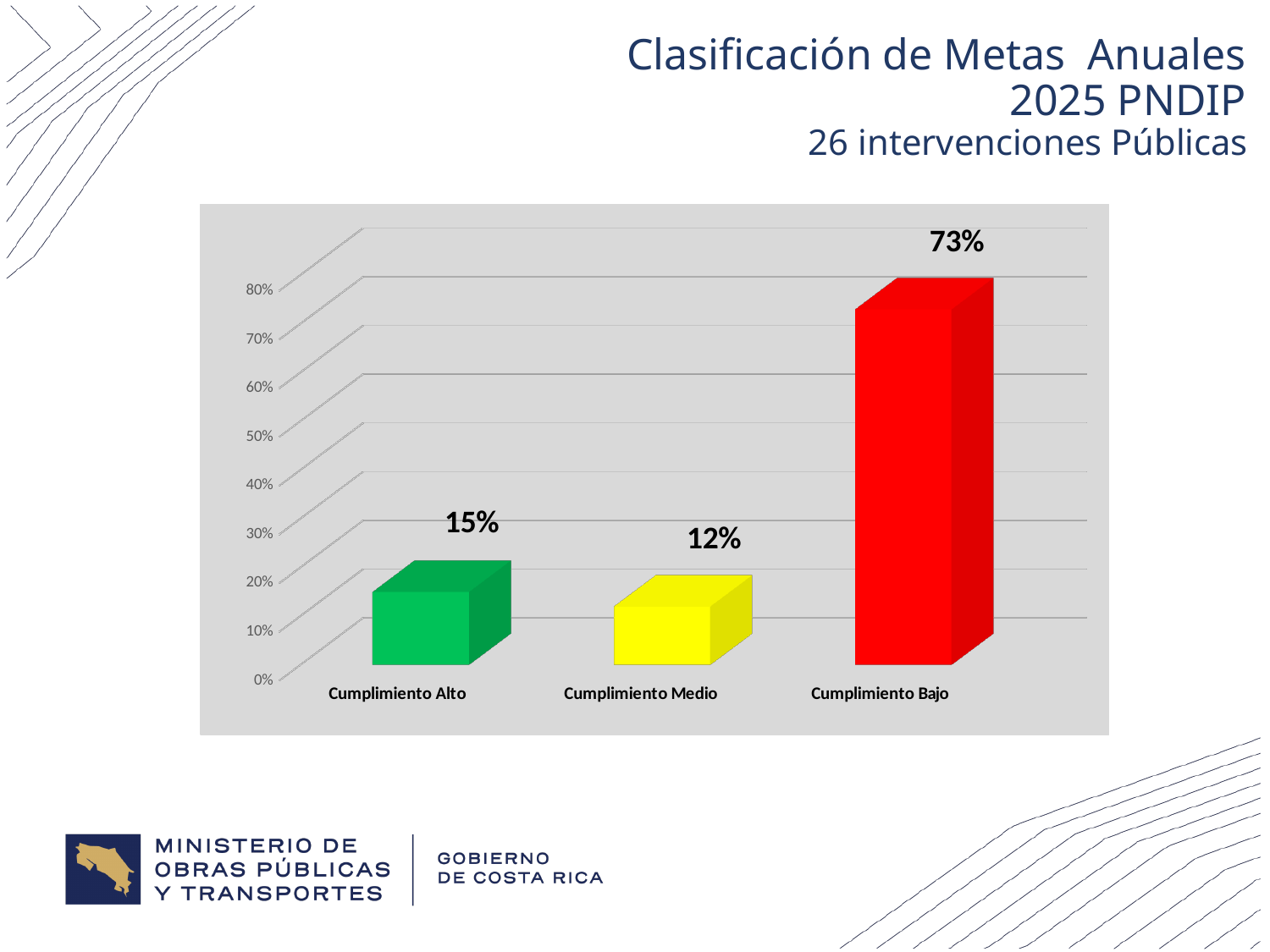
Which category has the lowest value? Cumplimiento Medio How many categories are shown in the chart? 3 What is the difference between the values for Cumplimiento Bajo and Cumplimiento Alto? 58% Is the value for Cumplimiento Bajo greater or less than 50%? greater What is the difference between the values for Cumplimiento Alto and Cumplimiento Medio? 3% What is the value for Cumplimiento Medio? 12% Which category has the highest value? Cumplimiento Bajo What colour is the bar for Cumplimiento Bajo? red Which is larger, the value for Cumplimiento Alto or Cumplimiento Medio? Cumplimiento Alto What is the value for Cumplimiento Bajo? 73% What is the value for Cumplimiento Alto? 15% What kind of chart is shown on the slide? bar chart